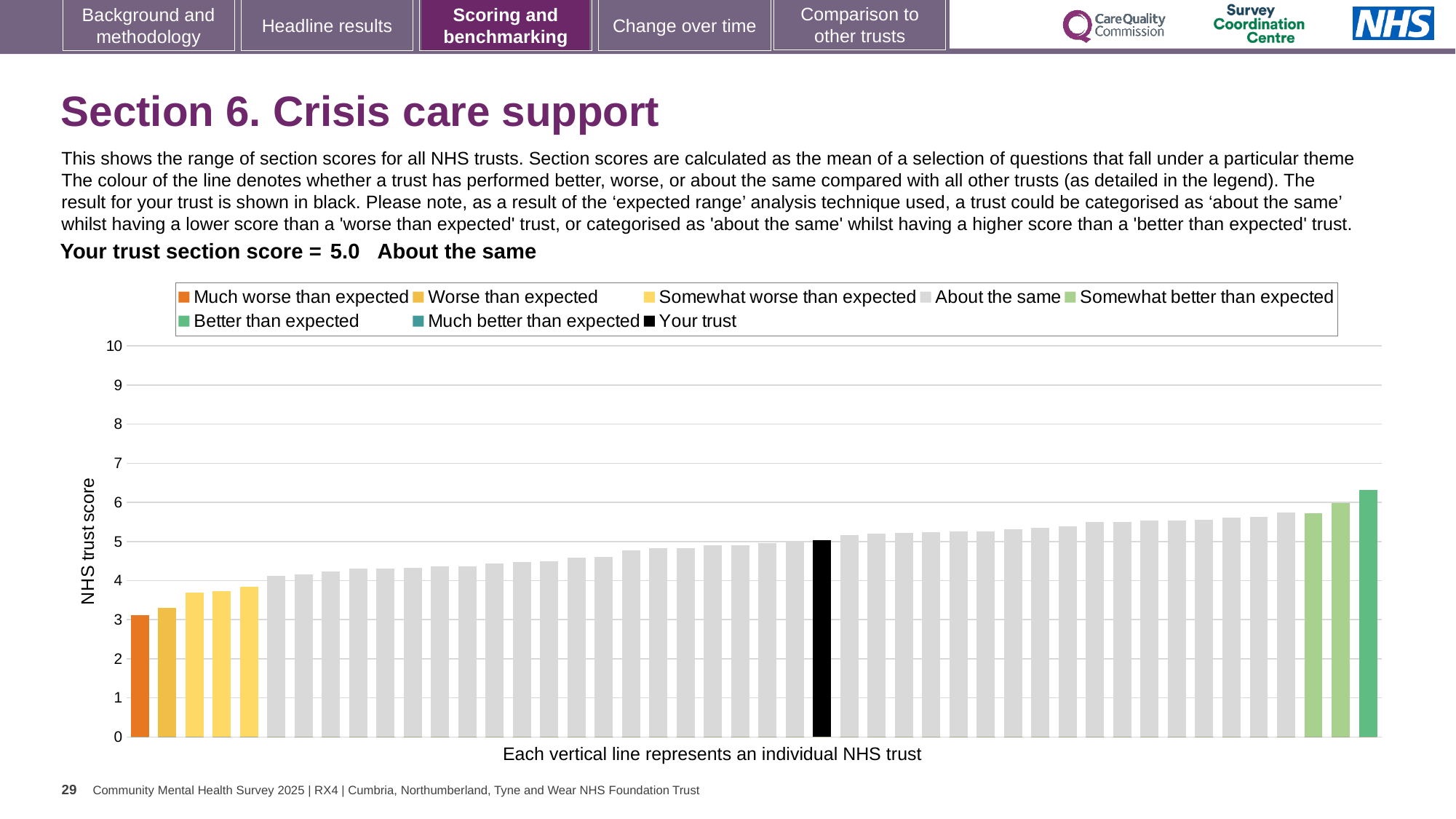
Which category does your trust fall into for this section? About the same Is the value of the lowest bar (the orange bar) greater or less than 4? less Which legend category does the tallest bar belong to? Better than expected What is the section score for your trust shown on the slide? 5.0 What is the label on the vertical axis of the chart? NHS trust score How many bars are coloured as 'Much worse than expected'? 1 Is the value of the black 'Your trust' bar greater or less than 4? greater How many entries does the chart legend list? 8 What kind of chart is shown on the slide? bar chart Do the bar values rise or fall from left to right across the chart? rise Is the value of the tallest bar greater or less than 6? greater How many bars are coloured as 'Somewhat better than expected'? 2